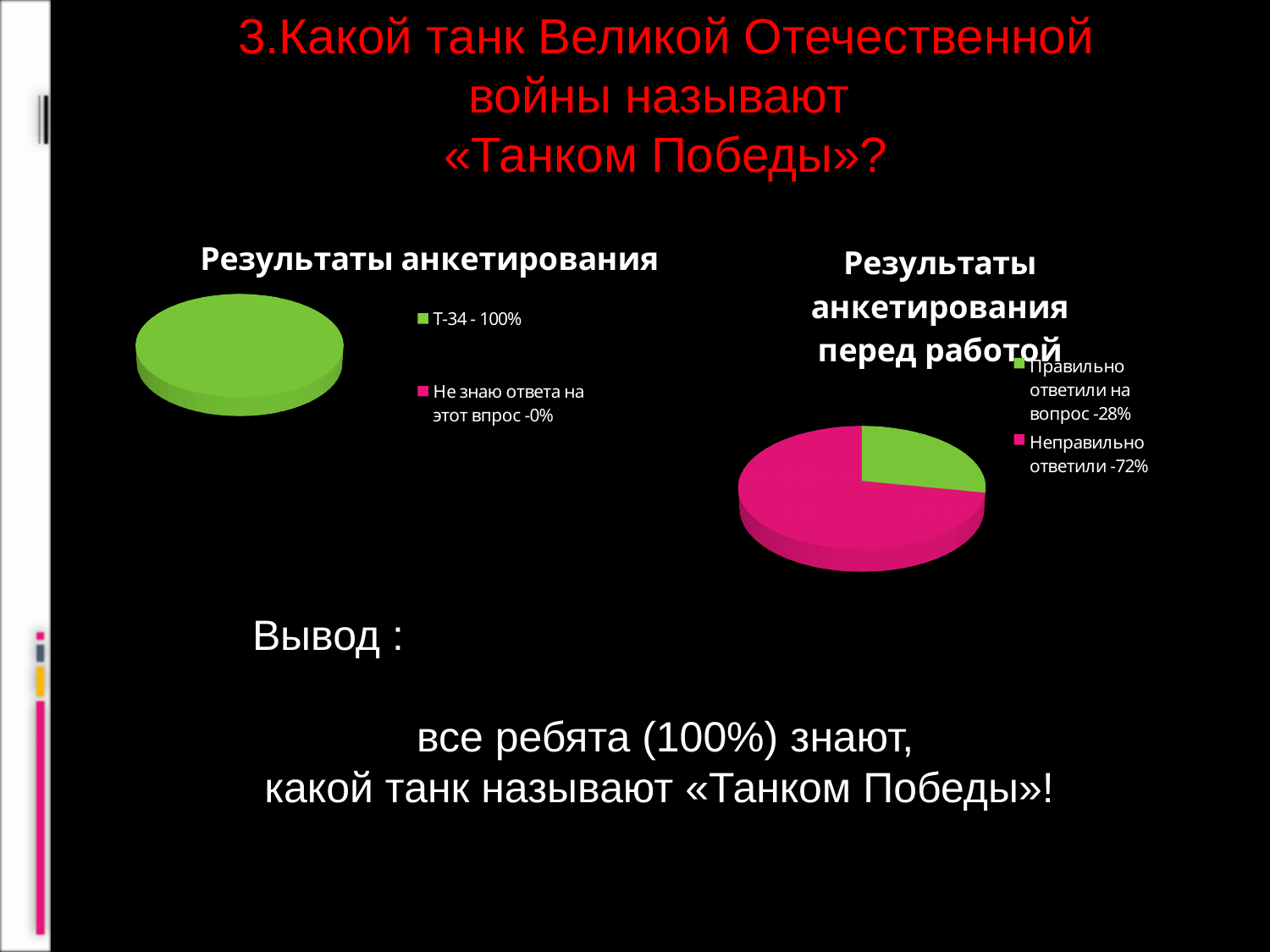
In the left chart "Результаты анкетирования", what share is given for "Не знаю ответа на этот впрос"? 0% In the right chart "Результаты анкетирования перед работой", what is the difference between the share of "Неправильно ответили" and "Правильно ответили на вопрос"? 44% In the right chart "Результаты анкетирования перед работой", which category has the largest slice? Неправильно ответили In the right chart "Результаты анкетирования перед работой", what colour is the slice for "Неправильно ответили"? pink In the right chart "Результаты анкетирования перед работой", which is larger: "Правильно ответили на вопрос" or "Неправильно ответили"? Неправильно ответили In the left chart "Результаты анкетирования", what share is given for "Т-34"? 100% In the right chart "Результаты анкетирования перед работой", what share is given for "Неправильно ответили"? 72% What kind of chart is the left chart titled "Результаты анкетирования"? pie chart In the right chart "Результаты анкетирования перед работой", which category has the smallest slice? Правильно ответили на вопрос What kind of chart is the right chart titled "Результаты анкетирования перед работой"? pie chart How many entries does the legend of the left chart "Результаты анкетирования" list? 2